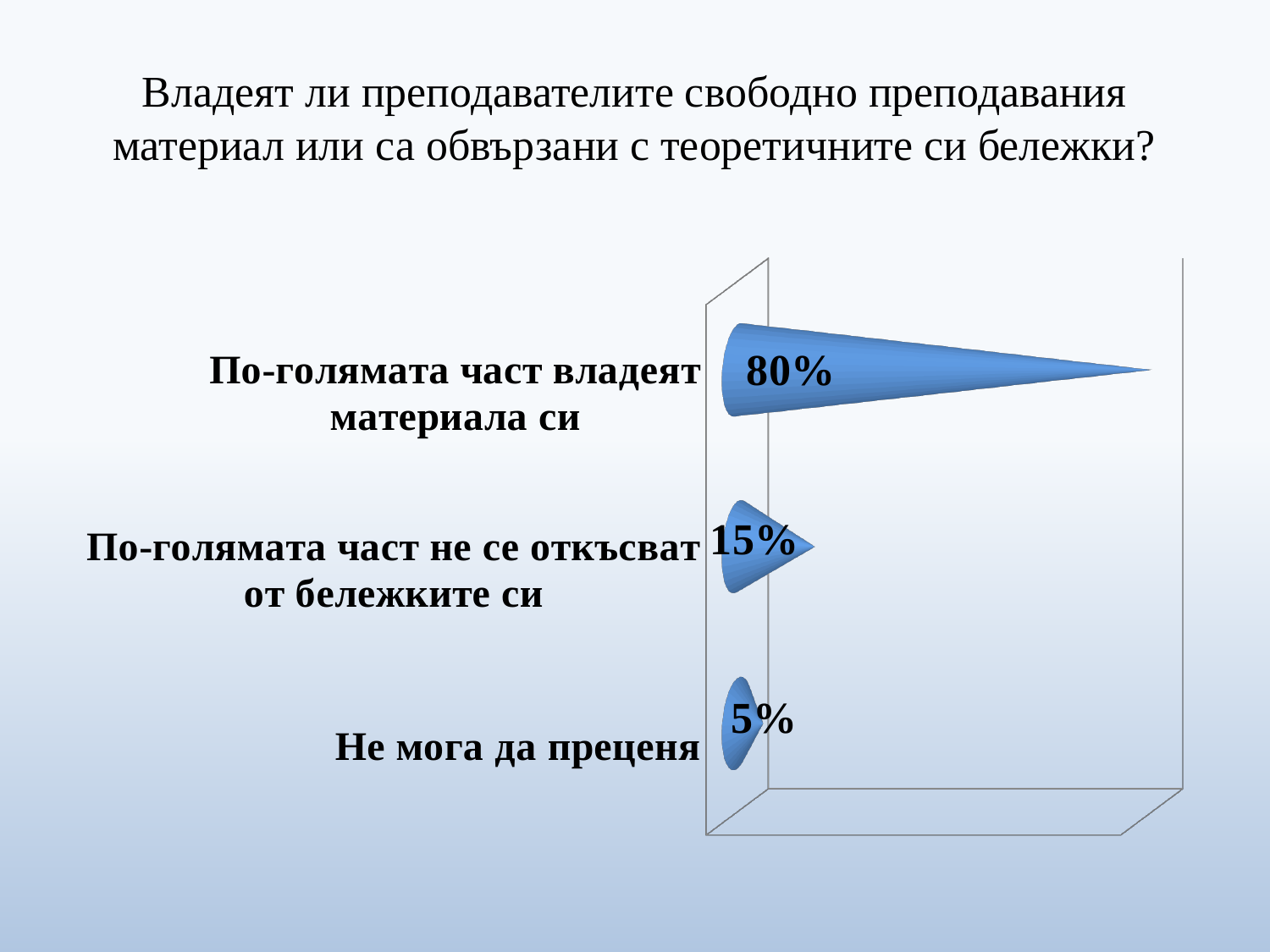
What colour are the bars in the chart? Blue What is the difference between the values for "По-голямата част не се откъсват от бележките си" and "Не мога да преценя"? 10% What kind of chart is shown on the slide? Bar chart Which category has the lowest value? Не мога да преценя What is the value for "По-голямата част не се откъсват от бележките си"? 15% What is the difference between the values for "По-голямата част владеят материала си" and "По-голямата част не се откъсват от бележките си"? 65% Which category has the highest value? По-голямата част владеят материала си What is the total of the three values shown in the chart? 100% What is the value for "По-голямата част владеят материала си"? 80% What is the value for "Не мога да преценя"? 5% Which is larger: the value for "По-голямата част не се откъсват от бележките си" or for "Не мога да преценя"? По-голямата част не се откъсват от бележките си How many categories are shown in the chart? 3